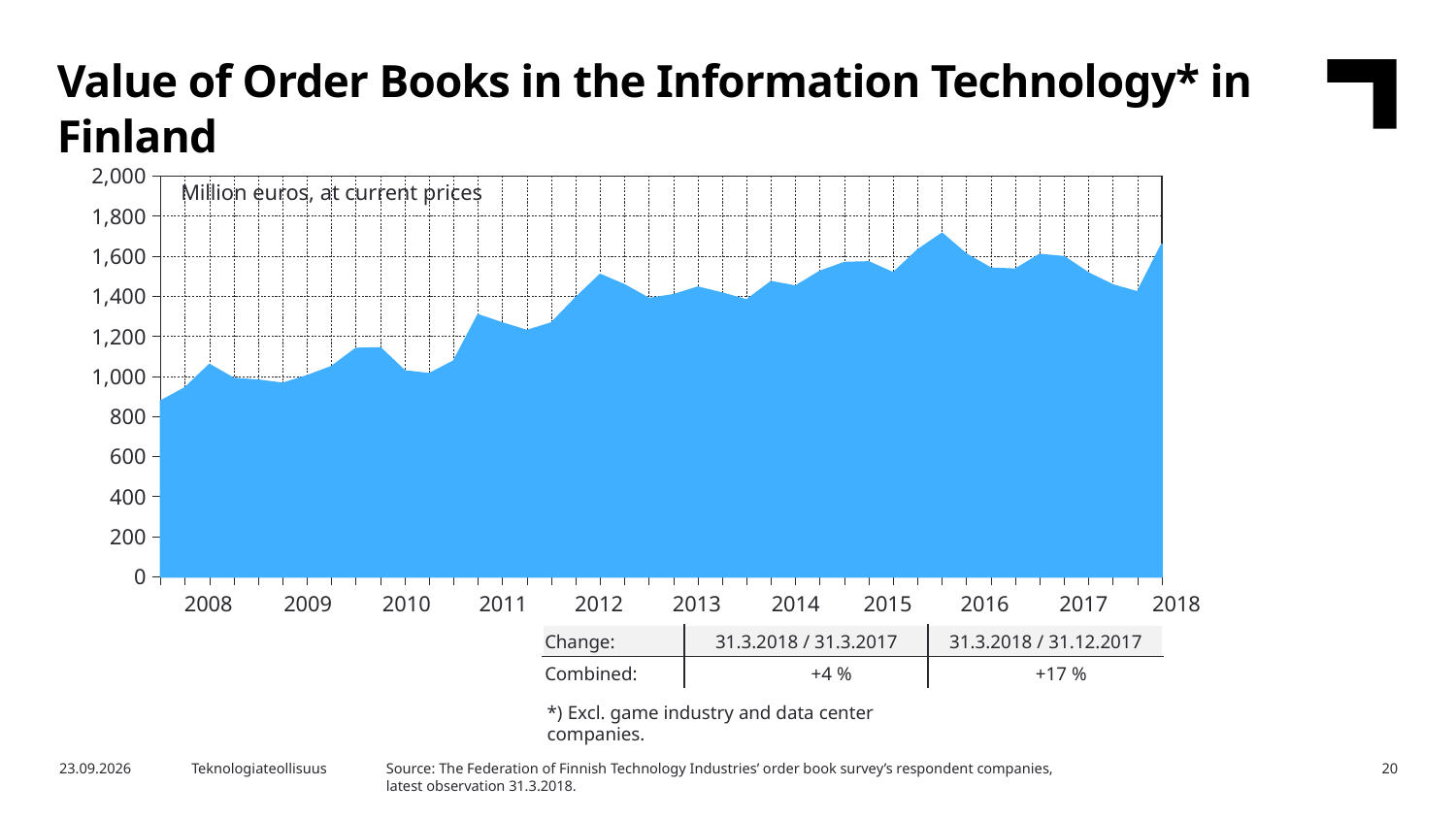
Is the peak value of order books reached in late 2015 greater or less than 1,600? greater Is the value of order books at the start of 2012 greater or less than 1,200? greater What is the combined change in order books for 31.3.2018 compared with 31.12.2017, as shown in the table below the chart? +17 % What is the title of the chart on the slide? Value of Order Books in the Information Technology* in Finland Is the value of order books at the 2018 end of the series greater or less than 1,400? greater In what unit are the values on the chart expressed, according to the label inside the plot area? Million euros, at current prices Overall, do the values of order books rise or fall from 2008 to 2018? rise What is the combined change in order books for 31.3.2018 compared with 31.3.2017, as shown in the table below the chart? +4 % What kind of chart is shown on the slide? Area chart How many year labels are shown on the x axis of the chart? 11